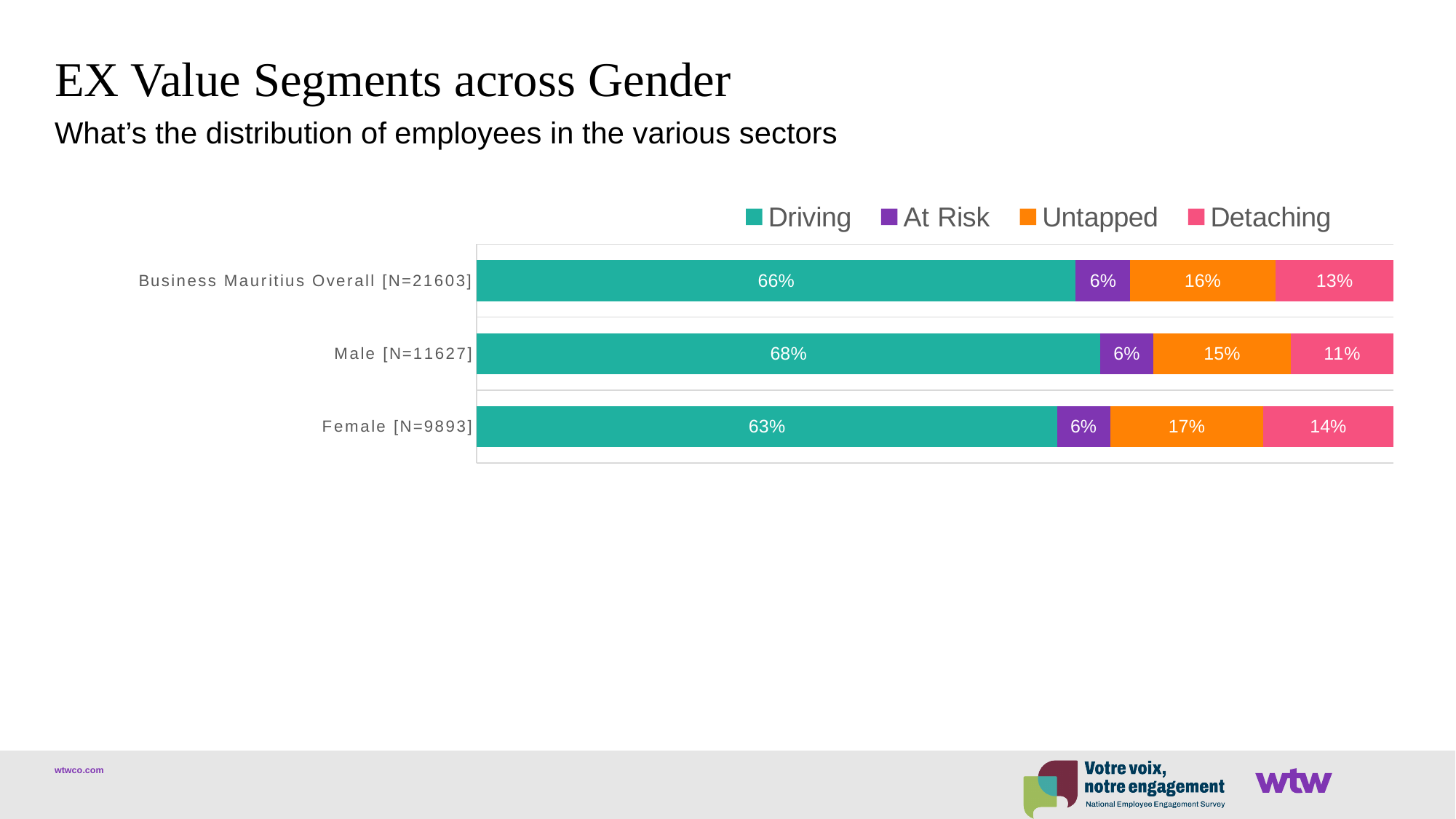
What is the Untapped value for Female [N=9893]? 17% Which category has the highest Driving value? Male [N=11627] How many series does the legend list? 4 Which category has the lowest Detaching value? Male [N=11627] How many categories are shown on the chart? 3 What kind of chart is shown on the slide? Stacked bar chart What is the difference between the Driving values for Male [N=11627] and Female [N=9893]? 5% What is the Detaching value for Business Mauritius Overall [N=21603]? 13% What is the total of the stacked bar for Female [N=9893]? 100% Which is larger, the Untapped value for Female [N=9893] or for Male [N=11627]? Female [N=9893] What is the Driving value for Male [N=11627]? 68% Which series is shown in orange in the legend? Untapped